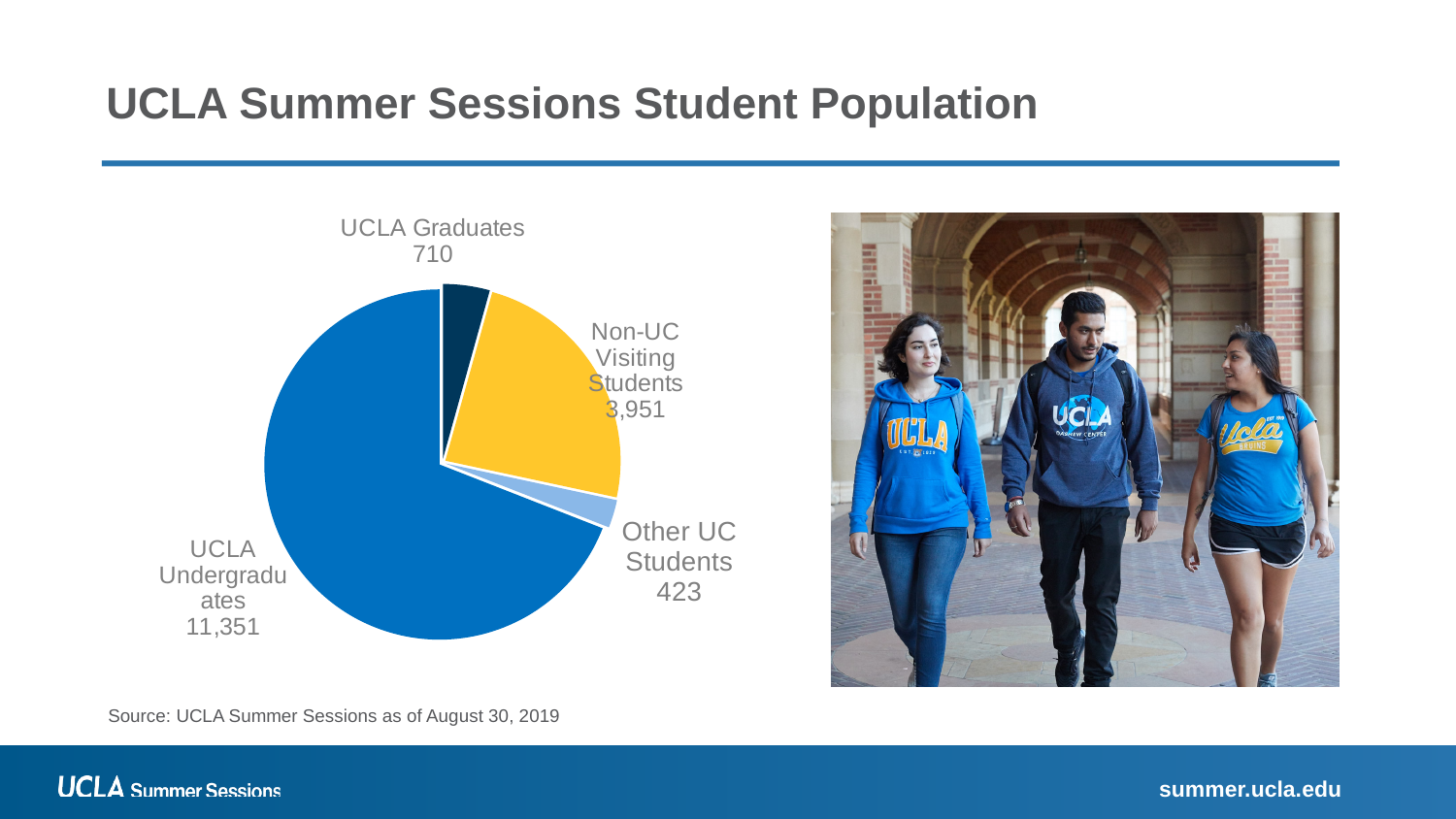
Which category has the smallest slice of the pie? Other UC Students What is the total of all four categories in the pie chart? 16,435 What is the value for Non-UC Visiting Students? 3,951 How many categories does the pie chart show? 4 What is the value for Other UC Students? 423 Which category has the largest slice of the pie? UCLA Undergraduates What is the difference between UCLA Undergraduates and Non-UC Visiting Students? 7,400 What is the value for UCLA Undergraduates? 11,351 What is the title of the chart on the slide? UCLA Summer Sessions Student Population Which is larger, UCLA Graduates or Other UC Students? UCLA Graduates What kind of chart is shown on the slide? Pie chart What is the value for UCLA Graduates? 710